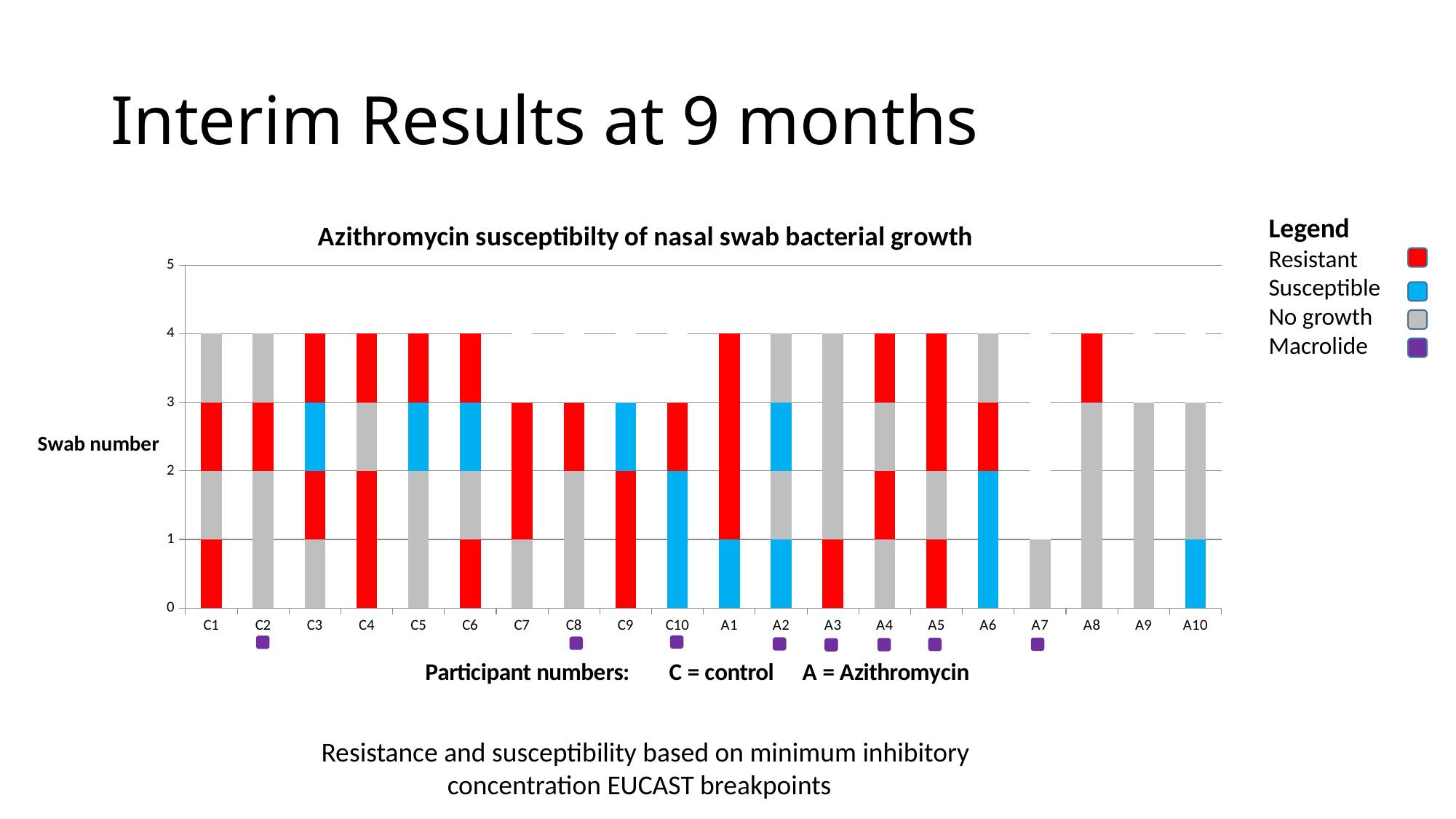
Which bar is taller, C1 or C9? C1 How many entries does the chart's legend list? 4 What is the title of the chart? Azithromycin susceptibilty of nasal swab bacterial growth What is the total bar height (number of swabs) for participant C7? 3 What is the total bar height (number of swabs) for participant A8? 4 Is the total bar height for A9 greater or less than 4? less How many participant categories are shown on the x axis of the chart? 20 What is the total bar height (number of swabs) for participant A7? 1 Which participant has the lowest total bar height in the chart? A7 What is the difference between the total bar heights of C6 and A7? 3 What is the label on the vertical axis of the chart? Swab number What kind of chart is shown on the slide? Stacked bar chart